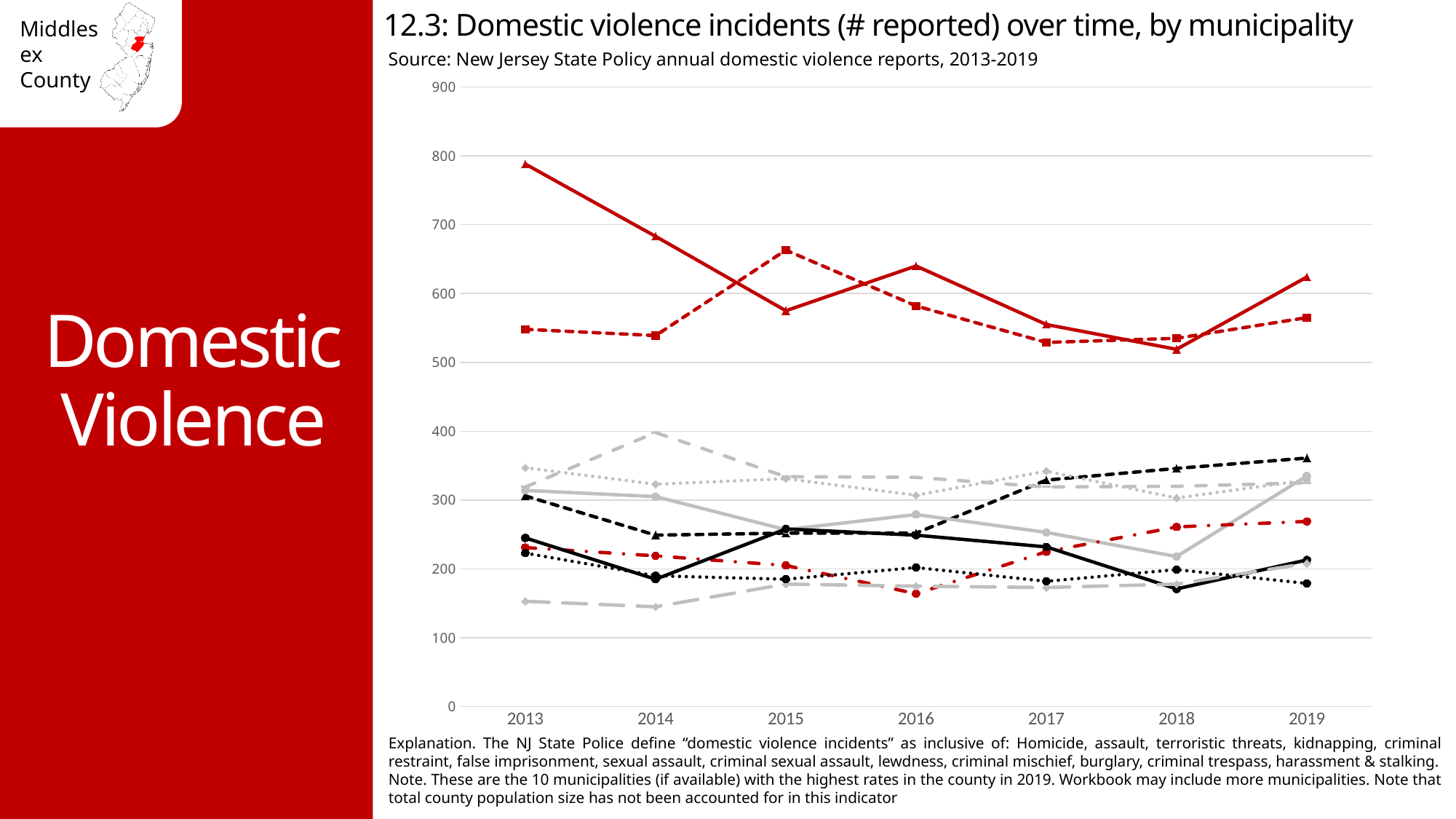
What is the first year shown on the x axis? 2013 Is the lowest value plotted in 2014 greater or less than 200? less What type of chart is shown on the slide? line chart How many years are shown along the x axis of the chart? 7 In which year does the topmost line reach its highest value? 2013 Is the highest value plotted in 2018 greater or less than 600? less Is the highest value plotted in 2013 greater or less than 700? greater How many lines (municipalities) are plotted on the chart? 10 Does the solid red line with triangle markers rise or fall from 2013 to 2015? fall What is the last year shown on the x axis? 2019